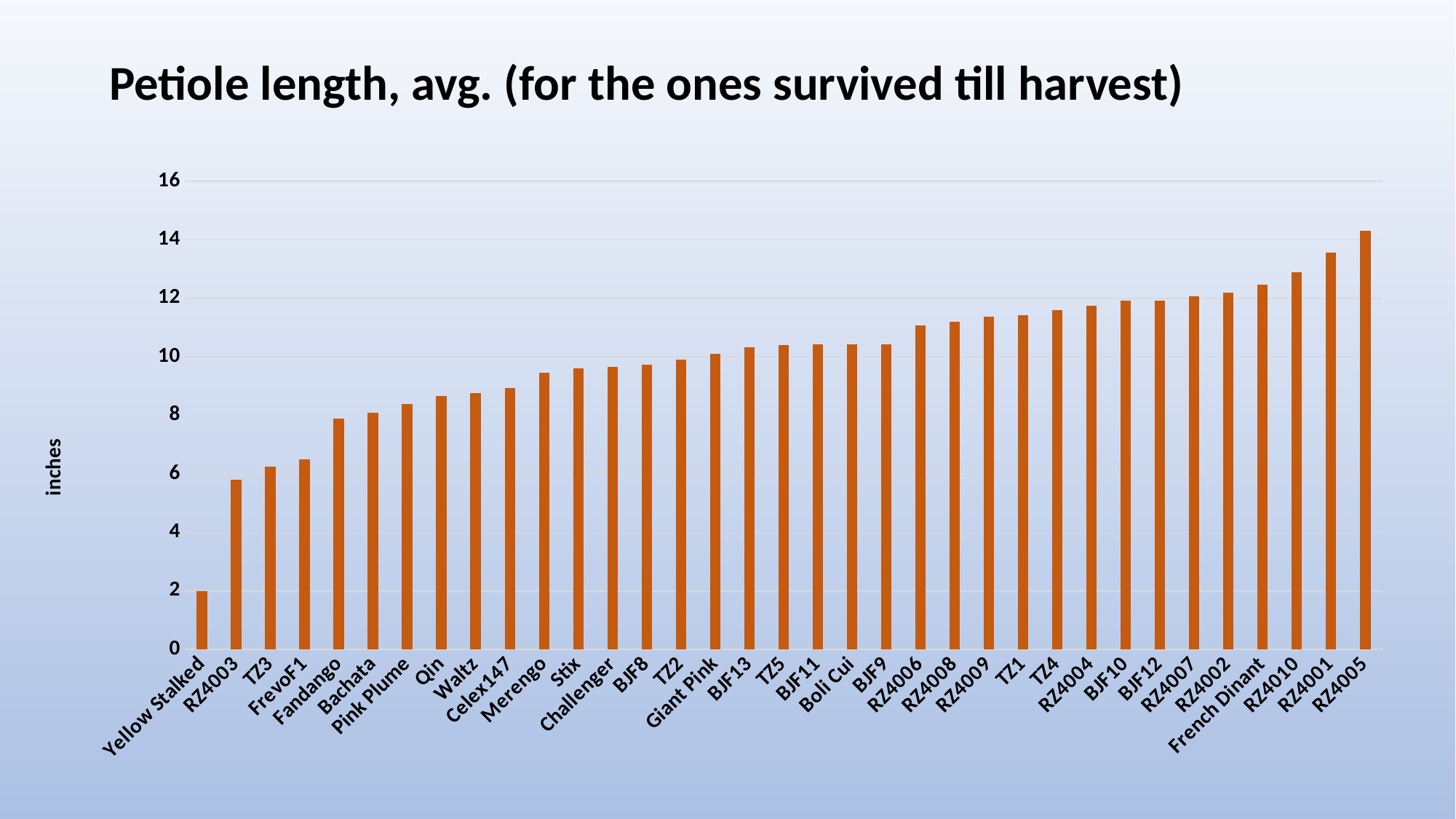
Which variety has the shortest average petiole length? Yellow Stalked Is the value for RZ4005 greater or less than 14? greater What is the label on the vertical axis of the chart? inches Do the bar values rise or fall from left to right along the x axis? rise Is the value for RZ4001 greater or less than 12? greater Is the value for Yellow Stalked greater or less than 4? less Which variety has the longest average petiole length? RZ4005 How many varieties are plotted on the chart? 35 What kind of chart is shown on the slide? bar chart Which has the larger average petiole length, Merengo or Fandango? Merengo What is the title of the chart? Petiole length, avg. (for the ones survived till harvest)